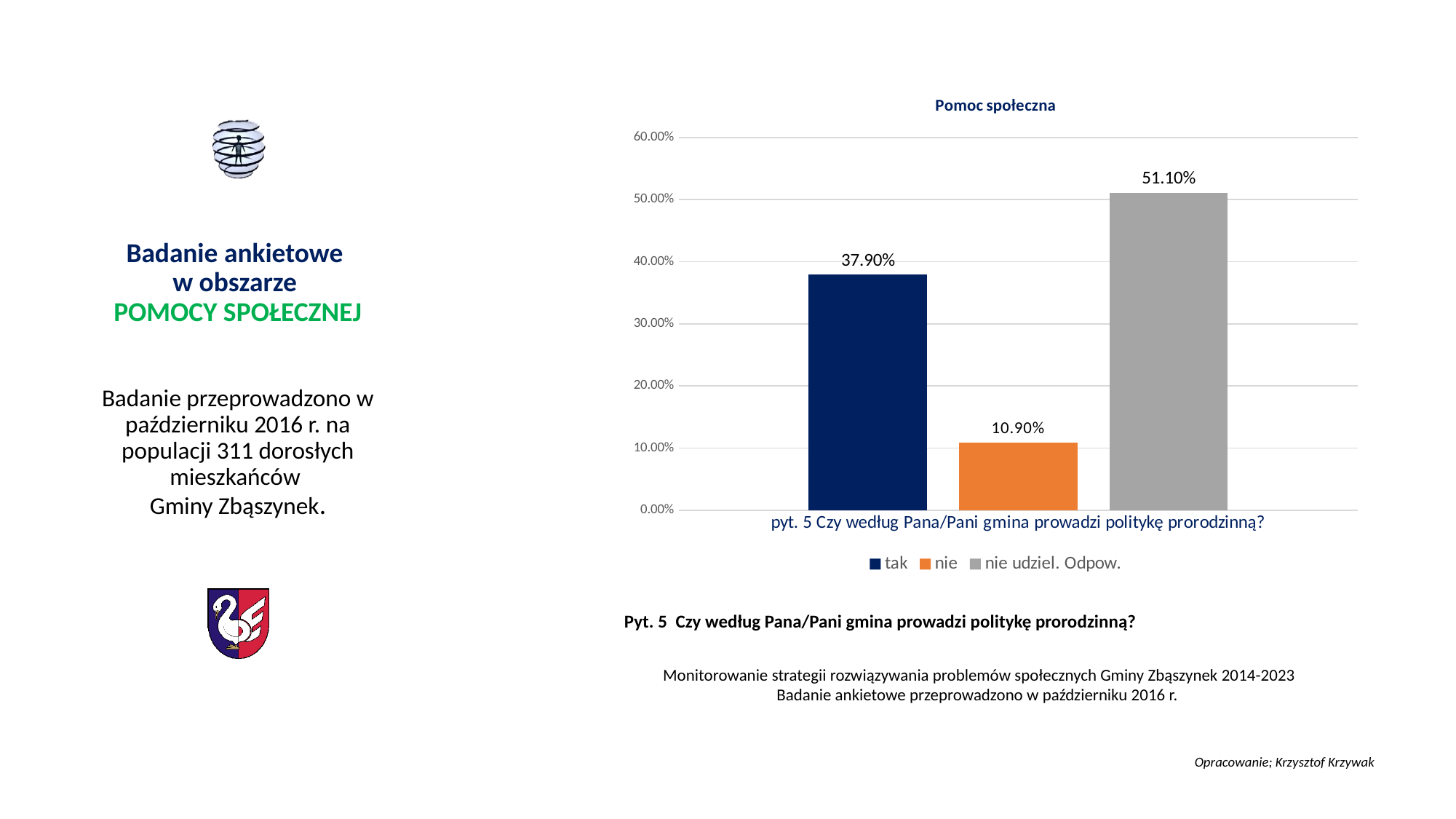
How many series does the legend list? 3 What is the difference between the values for "nie udziel. Odpow." and "tak"? 13.20% Is the value for "nie udziel. Odpow." greater or less than 50.00%? greater What kind of chart is shown on the slide? bar chart What is the difference between the values for "tak" and "nie"? 27.00% Which series has the highest value? nie udziel. Odpow. What is the value for "nie udziel. Odpow."? 51.10% What is the title of the chart? Pomoc społeczna Which is larger, the value for "tak" or the value for "nie"? tak What is the value for "nie"? 10.90% What is the value for "tak"? 37.90% Which series has the lowest value? nie